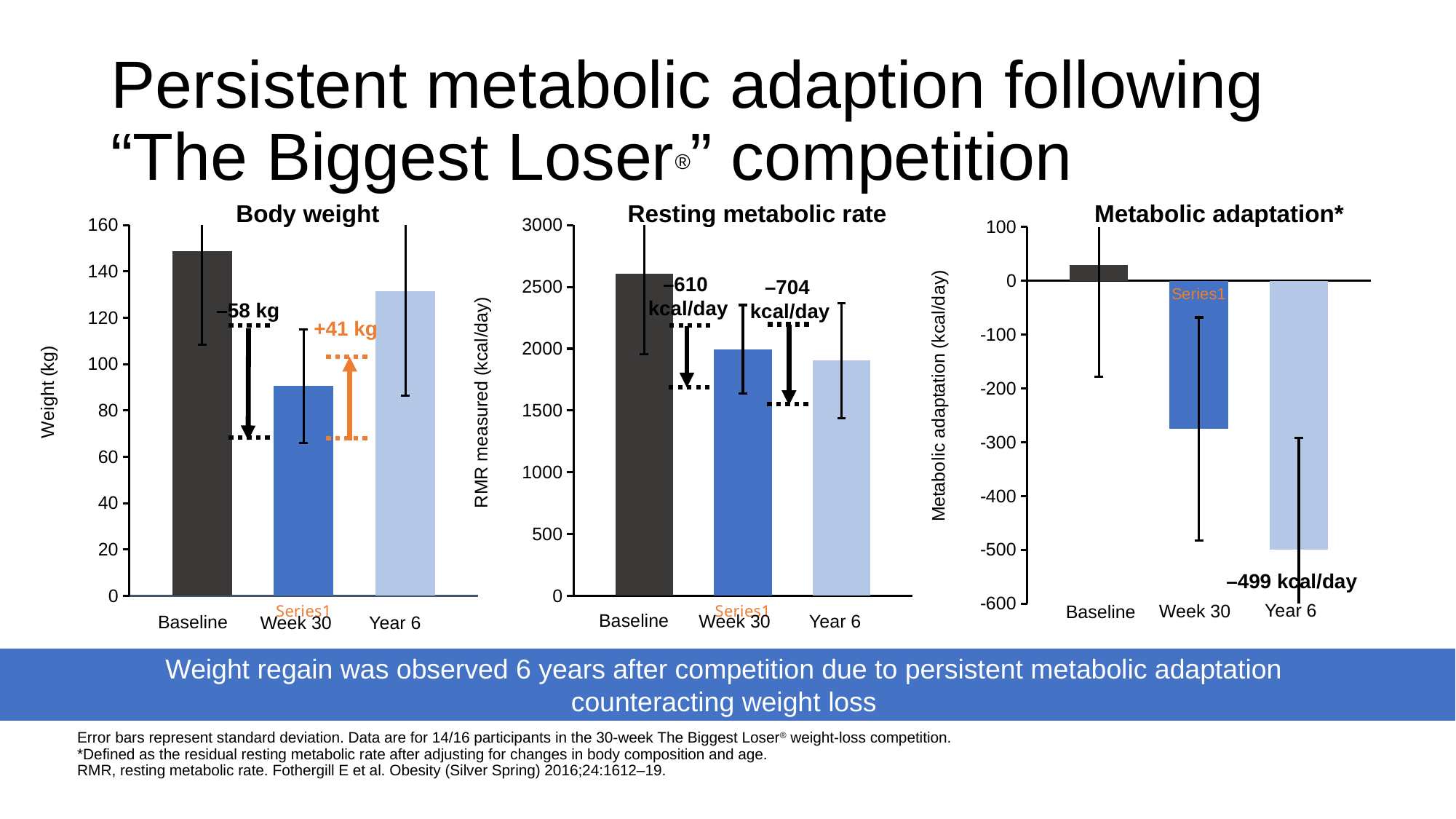
In the Resting metabolic rate chart, what change is annotated between Baseline and Week 30? –610 kcal/day In the Resting metabolic rate chart, what change is annotated between Baseline and Year 6? –704 kcal/day What kind of chart is the Body weight chart? bar chart How many time points are shown in the Resting metabolic rate chart? 3 In the Body weight chart, what change in weight is annotated between Baseline and Week 30? –58 kg In the Body weight chart, which time point has the highest weight? Baseline In the Body weight chart, what change in weight is annotated between Week 30 and Year 6? +41 kg In the Body weight chart, is the weight at Week 30 greater or less than 100 kg? less In the Body weight chart, which time point has the lowest weight? Week 30 In the Metabolic adaptation chart, what is the value labelled for Year 6? –499 kcal/day In the Resting metabolic rate chart, is the RMR at Baseline greater or less than 2500 kcal/day? greater In the Metabolic adaptation chart, which time point has the lowest value? Year 6